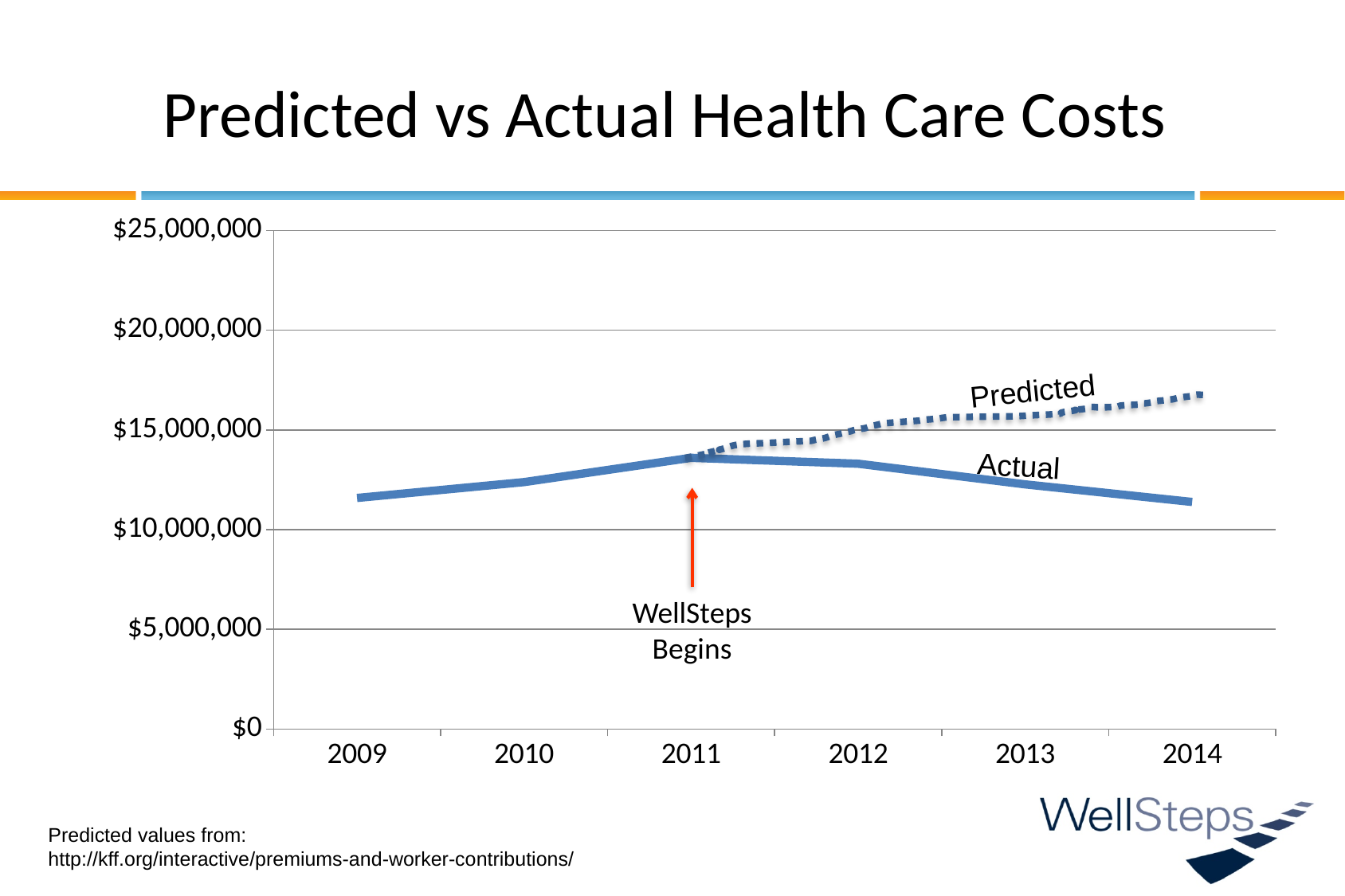
In which year does the Predicted series reach its highest value? 2014 Does the Actual series rise or fall from 2012 to 2014? fall In which year does the annotation say WellSteps begins? 2011 Is the Actual value for 2014 greater or less than $15,000,000? less Is the Actual value for 2009 greater or less than $10,000,000? greater In 2014, which is larger, the Predicted value or the Actual value? Predicted How many data series are plotted on the chart? 2 Is the Predicted value for 2014 greater or less than $15,000,000? greater What kind of chart is shown on the slide? line chart How many years are shown on the x axis of the chart? 6 Does the Predicted series rise or fall from 2011 to 2014? rise